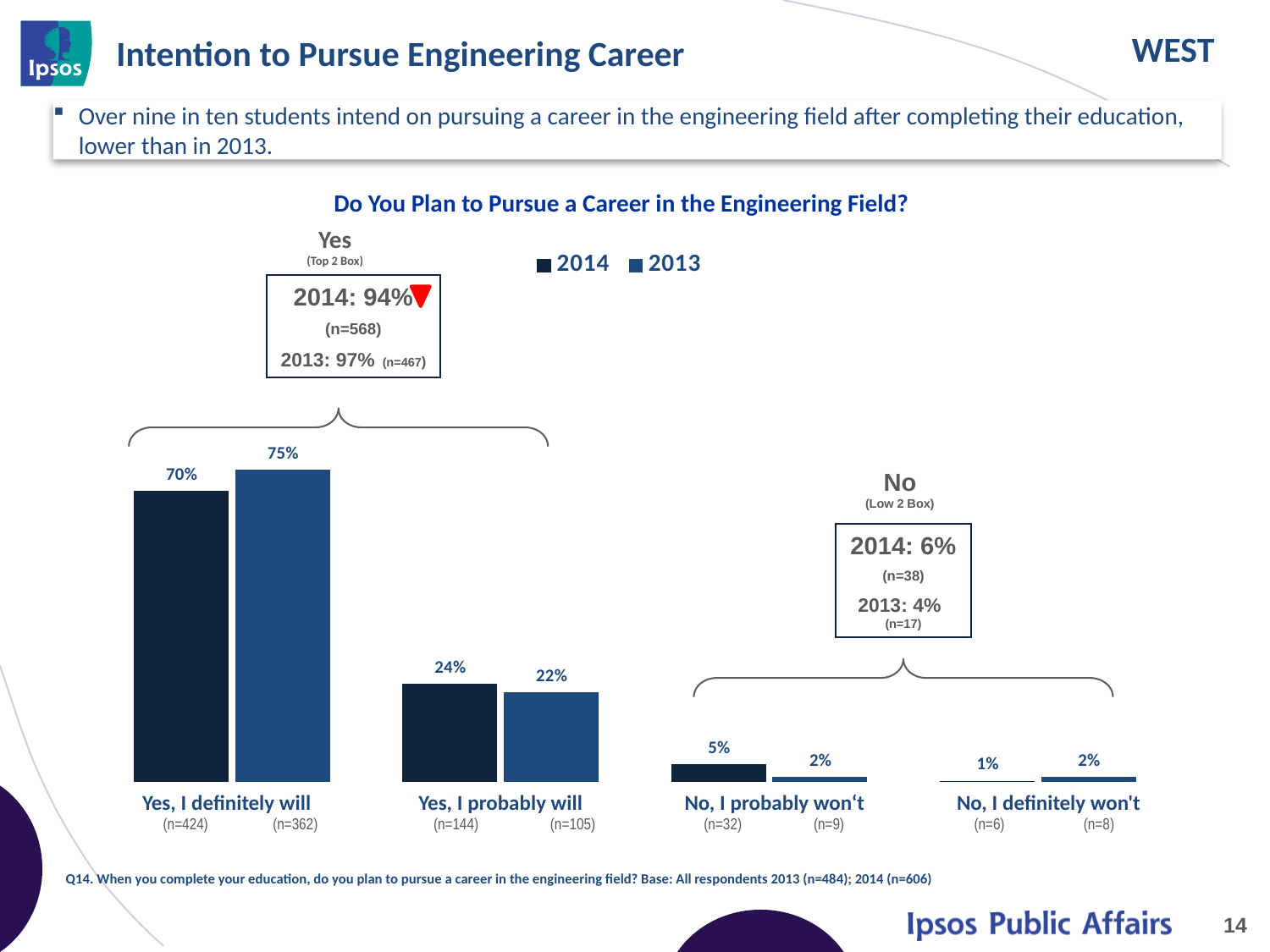
What is the 2014 value for "No, I probably won't"? 5% What is the title of the chart? Do You Plan to Pursue a Career in the Engineering Field? How many series does the legend list? 2 How many response categories are shown on the x axis? 4 Which category has the lowest 2014 value? No, I definitely won't What kind of chart is shown on the slide? Bar chart Which category has the highest 2013 value? Yes, I definitely will What is the 2013 value for "No, I definitely won't"? 2% What is the 2014 value for "Yes, I definitely will"? 70% What is the difference between the 2013 and 2014 values for "Yes, I definitely will"? 5% For "Yes, I probably will", which year has the larger value, 2014 or 2013? 2014 What is the 2013 value for "Yes, I probably will"? 22%